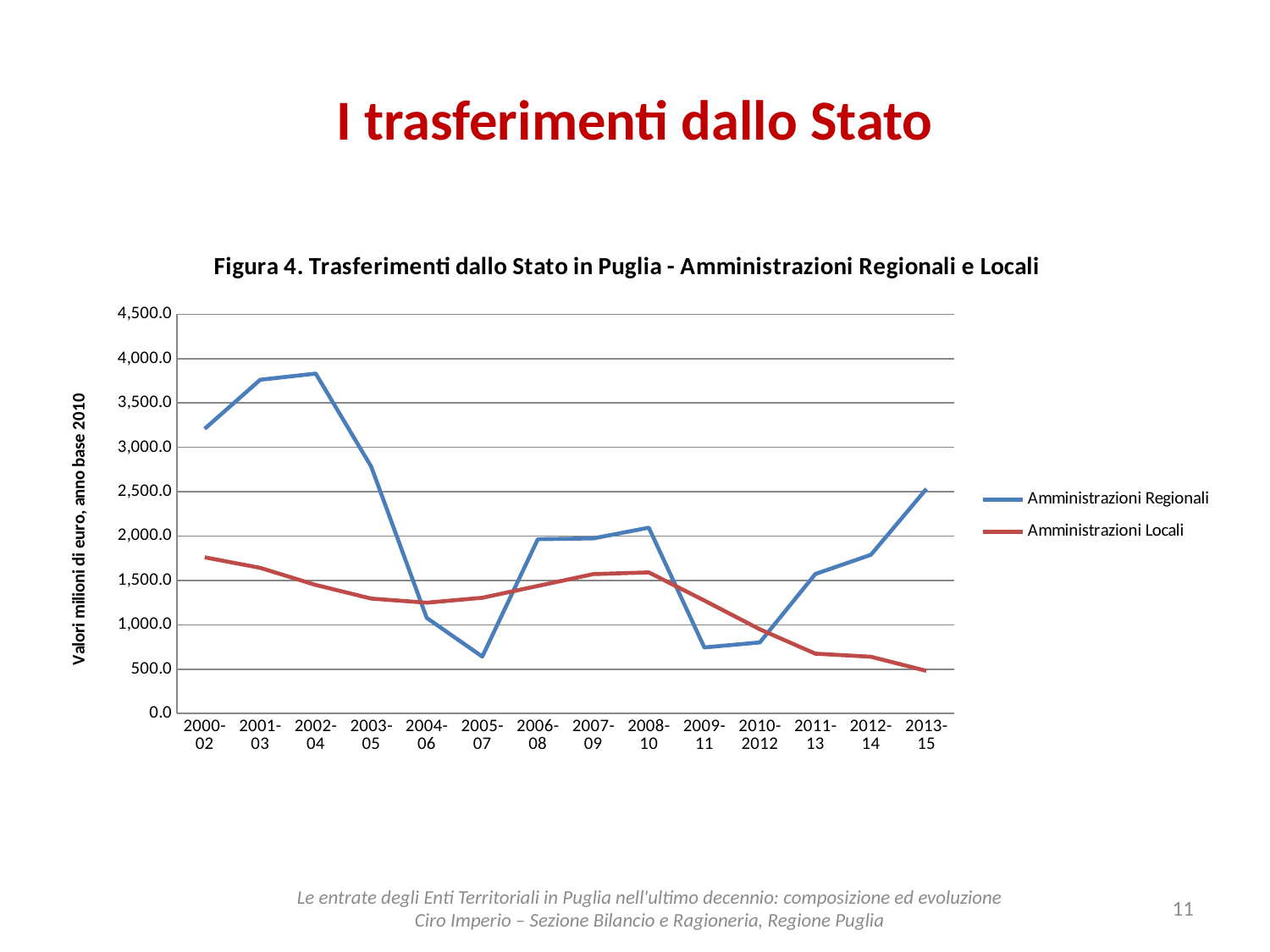
In which period does the Amministrazioni Regionali series reach its highest value? 2002-04 In which period does the Amministrazioni Regionali series reach its lowest value? 2005-07 In 2011-13, which series has the larger value, Amministrazioni Regionali or Amministrazioni Locali? Amministrazioni Regionali How many series does the legend list? 2 In which period does the Amministrazioni Locali series reach its highest value? 2000-02 Is the value for Amministrazioni Regionali in 2009-11 greater or less than 1,000.0? less Is the value for Amministrazioni Regionali in 2000-02 greater or less than 3,000.0? greater Does the Amministrazioni Locali series rise or fall from 2008-10 to 2013-15? fall How many periods are plotted along the x axis? 14 In which period does the Amministrazioni Locali series reach its lowest value? 2013-15 What kind of chart is shown on the slide? line chart Is the value for Amministrazioni Locali in 2013-15 greater or less than 1,000.0? less